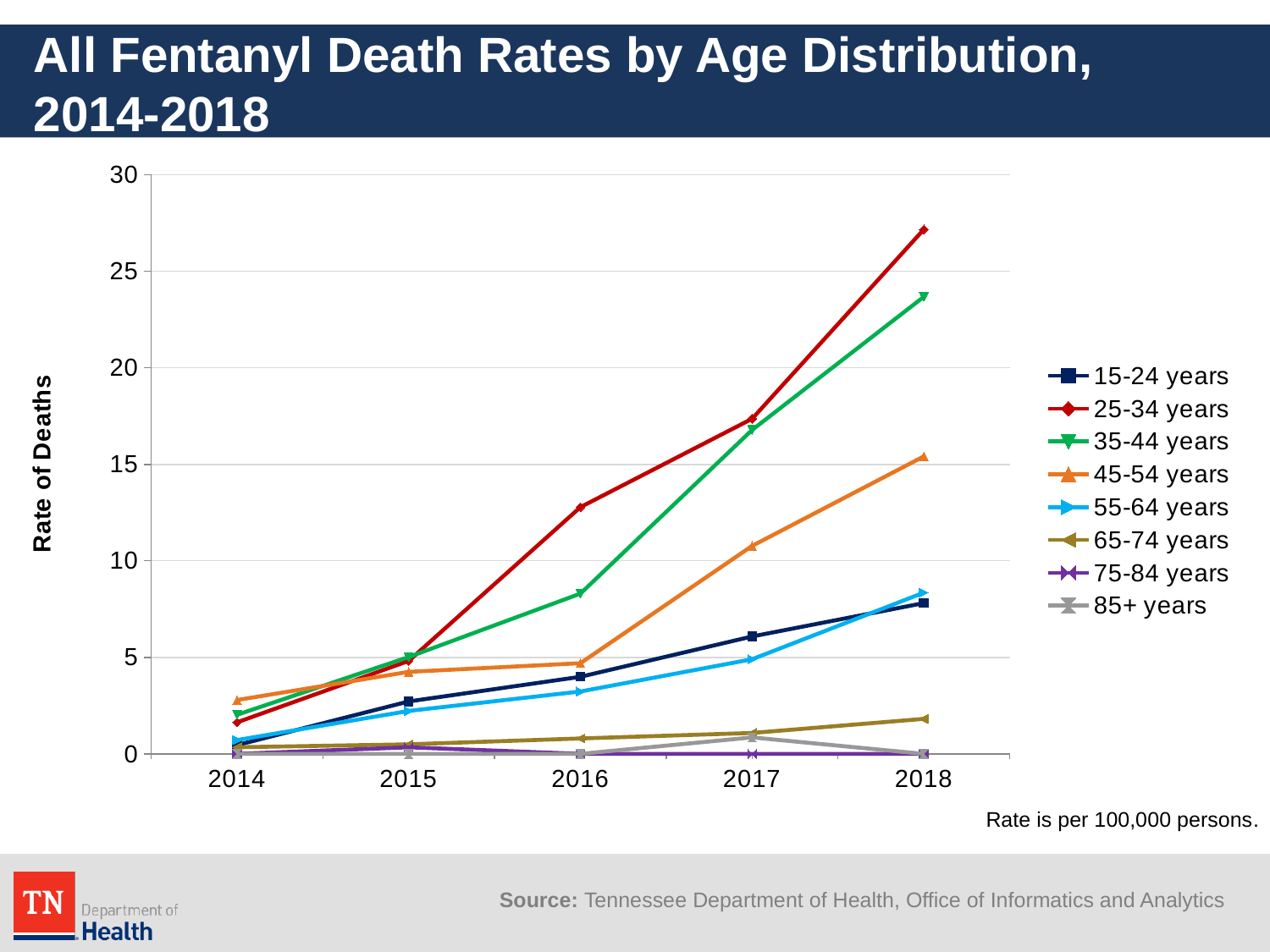
Is the value for 35-44 years in 2018 greater or less than 25? less In 2017, which is larger: the rate for 25-34 years or the rate for 45-54 years? 25-34 years Which age group has the highest fentanyl death rate in 2018? 25-34 years How many years are shown along the x axis? 5 What type of chart is shown on the slide? line chart Does the rate for 25-34 years rise or fall from 2014 to 2018? rise Is the value for 25-34 years in 2018 greater or less than 25? greater Is the value for 25-34 years in 2016 greater or less than 10? greater What is the title of the y axis? Rate of Deaths In 2016, which is larger: the rate for 35-44 years or the rate for 45-54 years? 35-44 years How many age groups does the legend list? 8